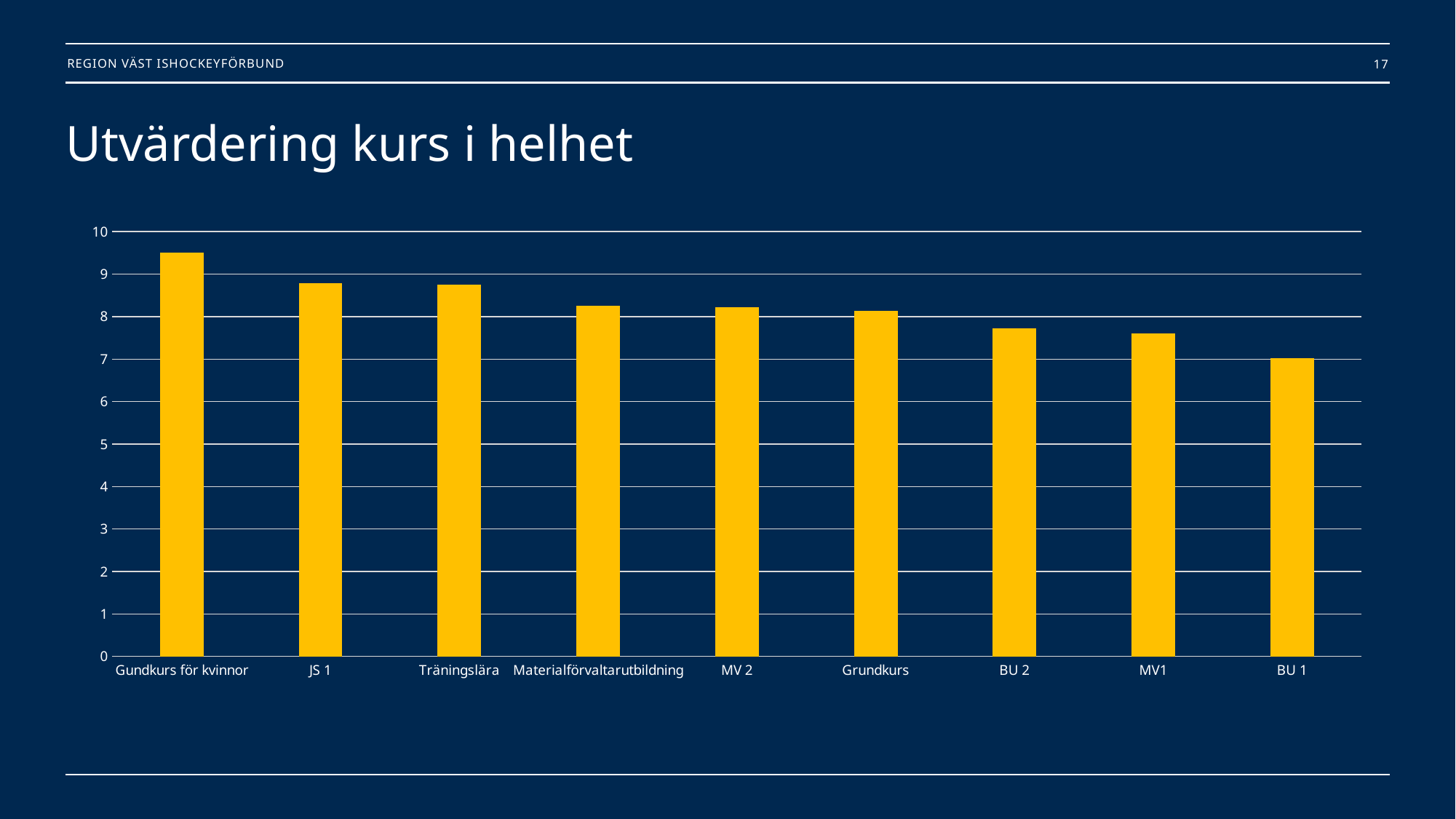
Which course has the highest value in the chart? Gundkurs för kvinnor Is the value for BU 1 greater or less than 8? less What is the title of the slide containing the chart? Utvärdering kurs i helhet Do the bar values generally rise or fall from left to right across the chart? Fall Which course has the lowest value in the chart? BU 1 How many courses (bars) are shown in the chart? 9 Is the value for BU 2 greater or less than 8? less Is the value for JS 1 greater or less than 8? greater Which has the larger value, Träningslära or BU 2? Träningslära What kind of chart is shown on the slide? Bar chart Which has the larger value, JS 1 or MV 2? JS 1